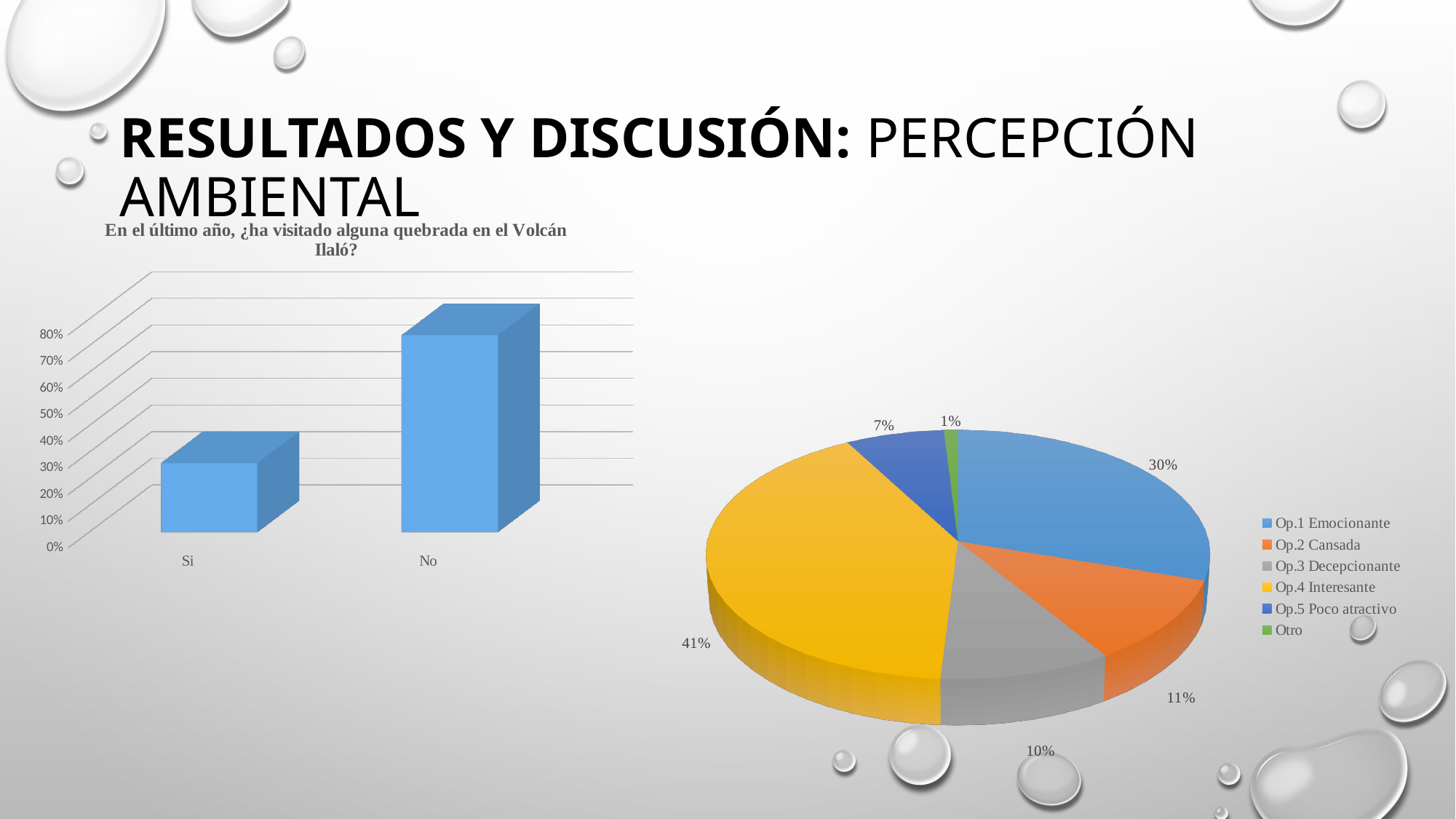
In the bar chart on the left, which category has the higher value, Si or No? No In the pie chart on the right, which option has the largest share? Op.4 Interesante In the pie chart on the right, what is the difference between the shares of Op.2 Cansada and Op.3 Decepcionante? 1% In the bar chart on the left, is the value for Si greater or less than 50%? less In the pie chart on the right, which option has the smallest share? Otro How many categories are shown in the bar chart on the left? 2 What is the title of the bar chart on the left? En el último año, ¿ha visitado alguna quebrada en el Volcán Ilaló? What type of chart is the chart on the left of the slide? Bar chart In the pie chart on the right, what share does Op.4 Interesante have? 41% In the pie chart on the right, what share does Op.1 Emocionante have? 30% How many entries does the legend of the pie chart on the right list? 6 In the bar chart on the left, is the value for No greater or less than 60%? greater